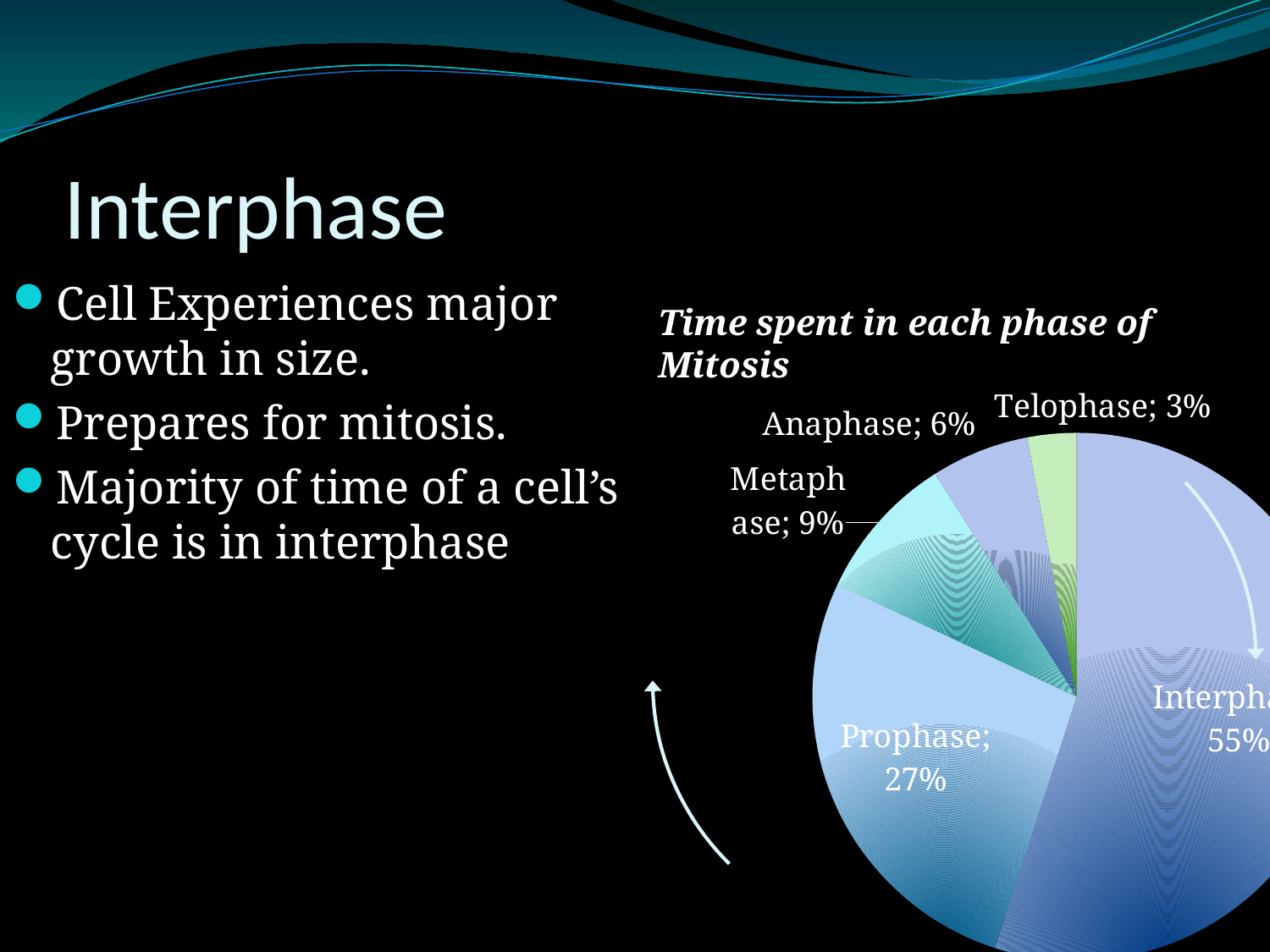
What percentage of time is spent in Anaphase? 6% What kind of chart is shown on the slide? Pie chart Which phase takes up the largest share of the pie? Interphase Which is larger, the share for Anaphase or the share for Telophase? Anaphase How many phases (slices) are shown in the pie chart? 5 Which phase takes up the smallest share of the pie? Telophase What percentage of time is spent in Prophase? 27% What percentage of time is spent in Interphase? 55% What is the title of the chart? Time spent in each phase of Mitosis What percentage of time is spent in Telophase? 3% What percentage of time is spent in Metaphase? 9% What is the difference in percentage between Prophase and Metaphase? 18%